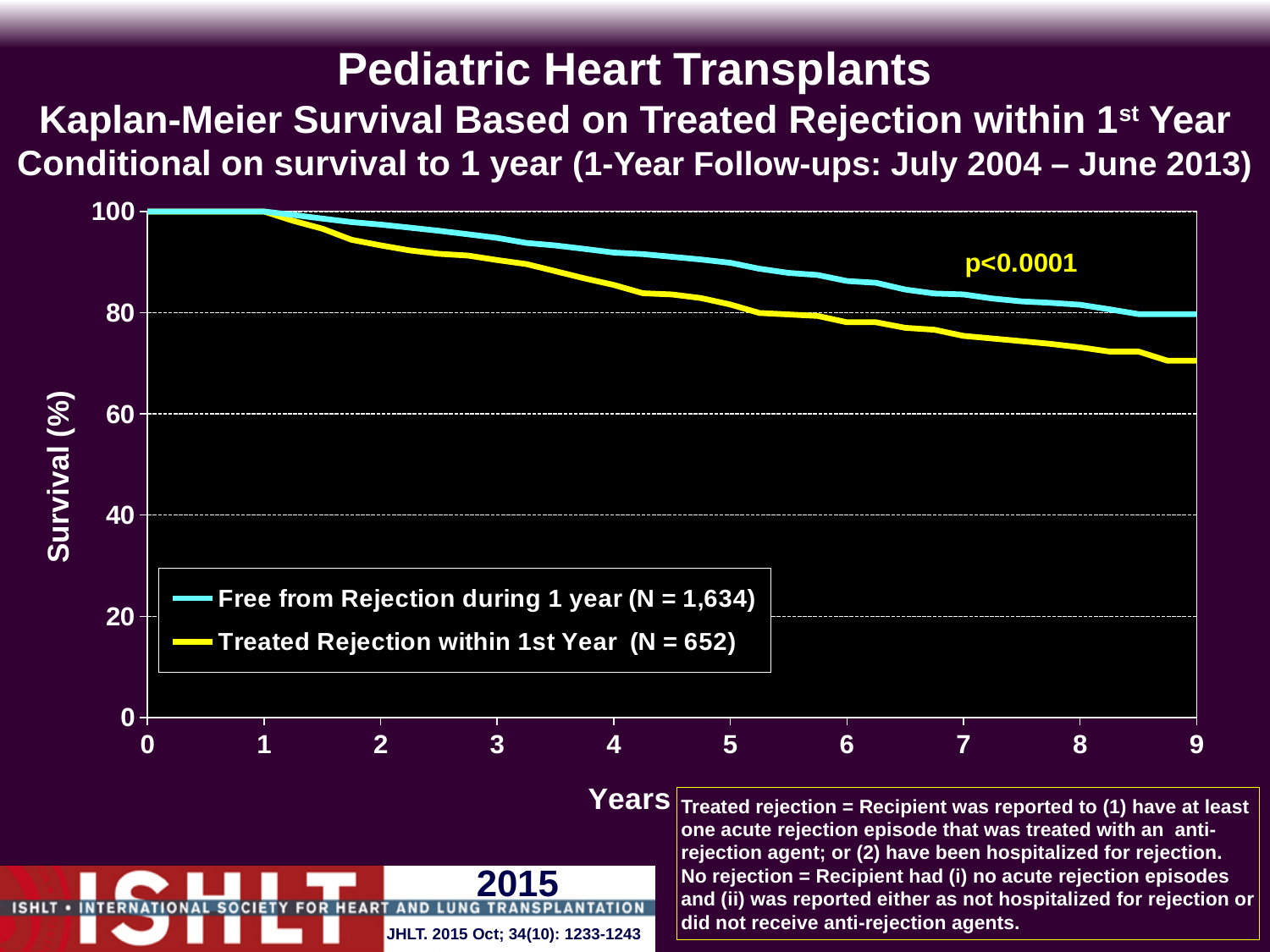
At year 5, which group has higher survival: Free from Rejection during 1 year or Treated Rejection within 1st Year? Free from Rejection during 1 year At year 9, which group has the lower survival? Treated Rejection within 1st Year What kind of chart is shown on the slide? Line chart What is the N for the Treated Rejection within 1st Year group shown in the legend? 652 Is the survival for Treated Rejection within 1st Year at year 9 greater or less than 80? less Do the survival curves rise or fall as the years increase? Fall What p-value is printed on the chart? p<0.0001 Is the survival for Treated Rejection within 1st Year at year 4 greater or less than 80? greater How many series does the legend list? 2 Is the survival for Free from Rejection during 1 year at year 7 greater or less than 80? greater